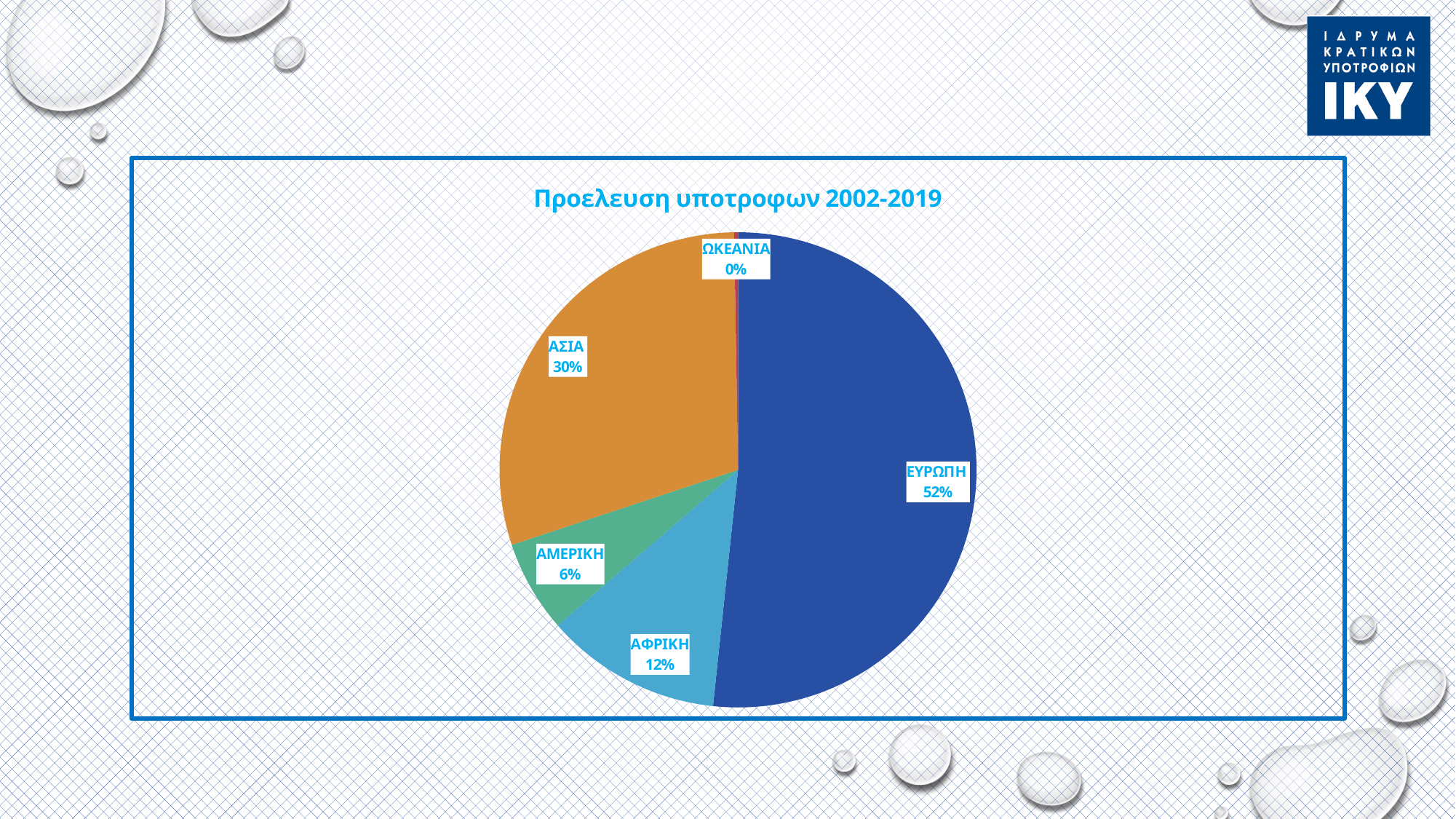
What share of the pie does ΑΣΙΑ have? 30% What share of the pie does ΑΦΡΙΚΗ have? 12% What share of the pie does ΕΥΡΩΠΗ have? 52% Which is larger, the share for ΑΦΡΙΚΗ or the share for ΑΜΕΡΙΚΗ? ΑΦΡΙΚΗ Which category has the largest slice of the pie? ΕΥΡΩΠΗ What is the title of the chart? Προελευση υποτροφων 2002-2019 What is the difference in percentage points between ΕΥΡΩΠΗ and ΑΣΙΑ? 22 What kind of chart is shown on the slide? pie chart Which category has the smallest slice of the pie? ΩΚΕΑΝΙΑ How many categories are shown in the pie chart? 5